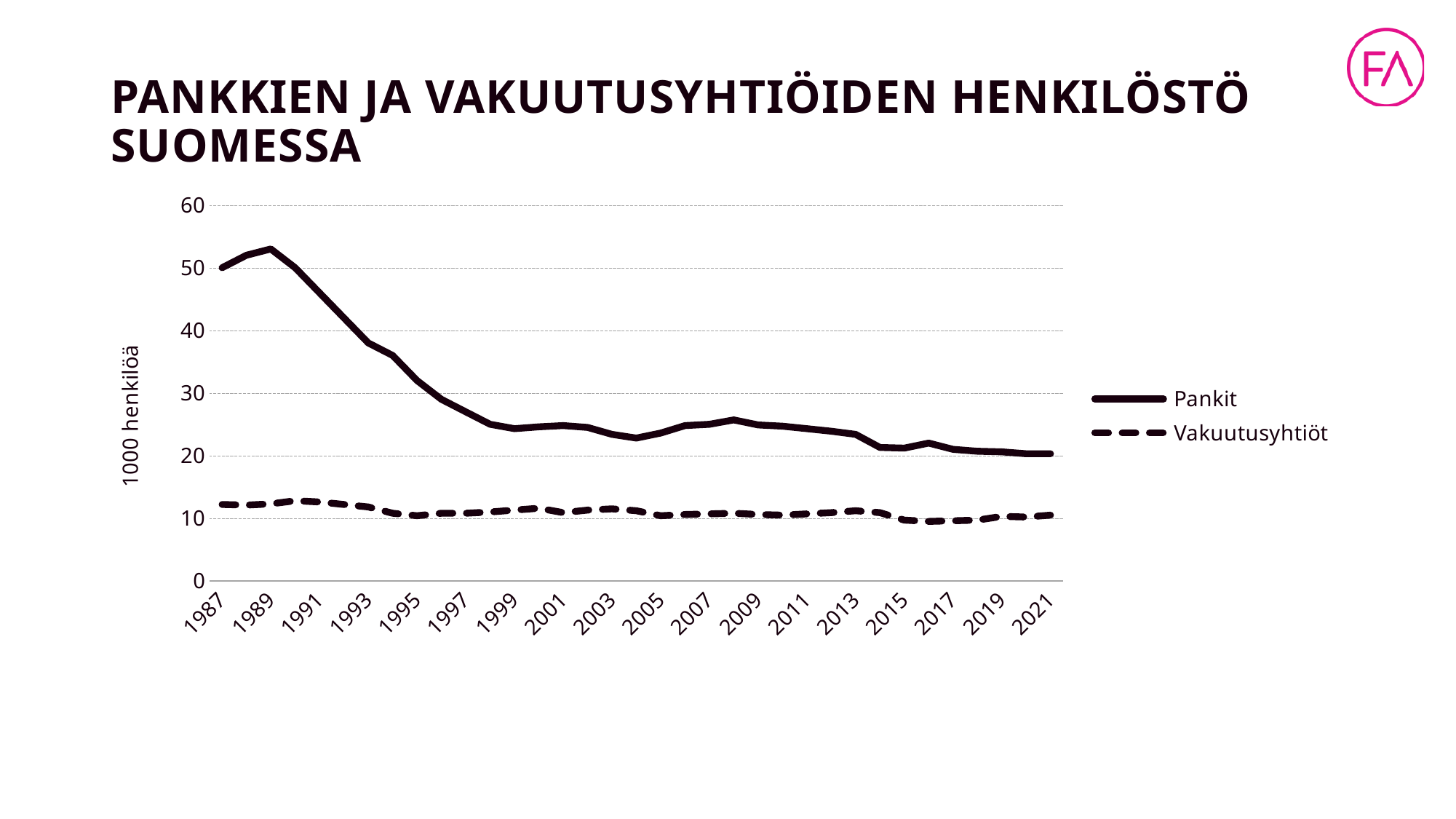
Is the value for Pankit in 2021 greater or less than 30? less Is the value for Pankit in 1995 greater or less than 40? less Does the Pankit line rise or fall overall from 1987 to 2021? fall Is the value for Vakuutusyhtiöt in 2021 greater or less than 20? less What kind of chart is shown on the slide? line chart What are the two series named in the legend? Pankit and Vakuutusyhtiöt What is the label on the vertical axis? 1000 henkilöä How many series does the legend list? 2 In 2021, which series has the higher value, Pankit or Vakuutusyhtiöt? Pankit In which year does the Pankit line reach its highest value? 1989